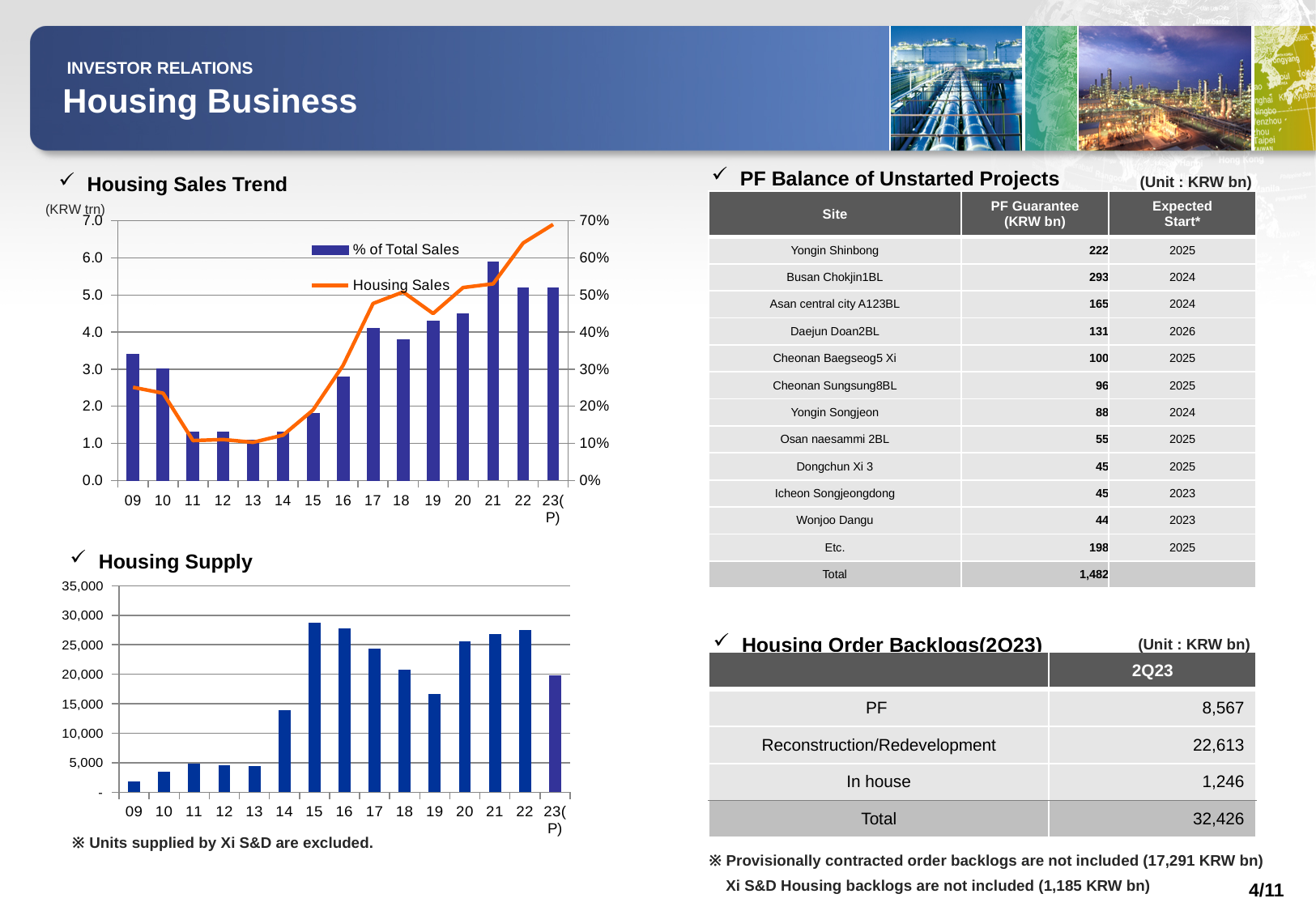
In the Housing Supply chart, which year has the lowest value? 09 In the Housing Supply chart, is the value for 14 greater or less than 10,000? greater In the Housing Sales Trend chart, does the Housing Sales line rise or fall from 14 to 18? rise In the Housing Supply chart, which is larger, the value for 15 or the value for 19? 15 What kind of chart is the Housing Sales Trend chart? A combined bar and line chart How many years are shown on the x axis of the Housing Sales Trend chart? 15 In the Housing Sales Trend chart, which year has the tallest bar? 21 How many series does the legend of the Housing Sales Trend chart list? 2 What does the footnote below the Housing Supply chart say is excluded? Units supplied by Xi S&D What kind of chart is the Housing Supply chart? Bar chart